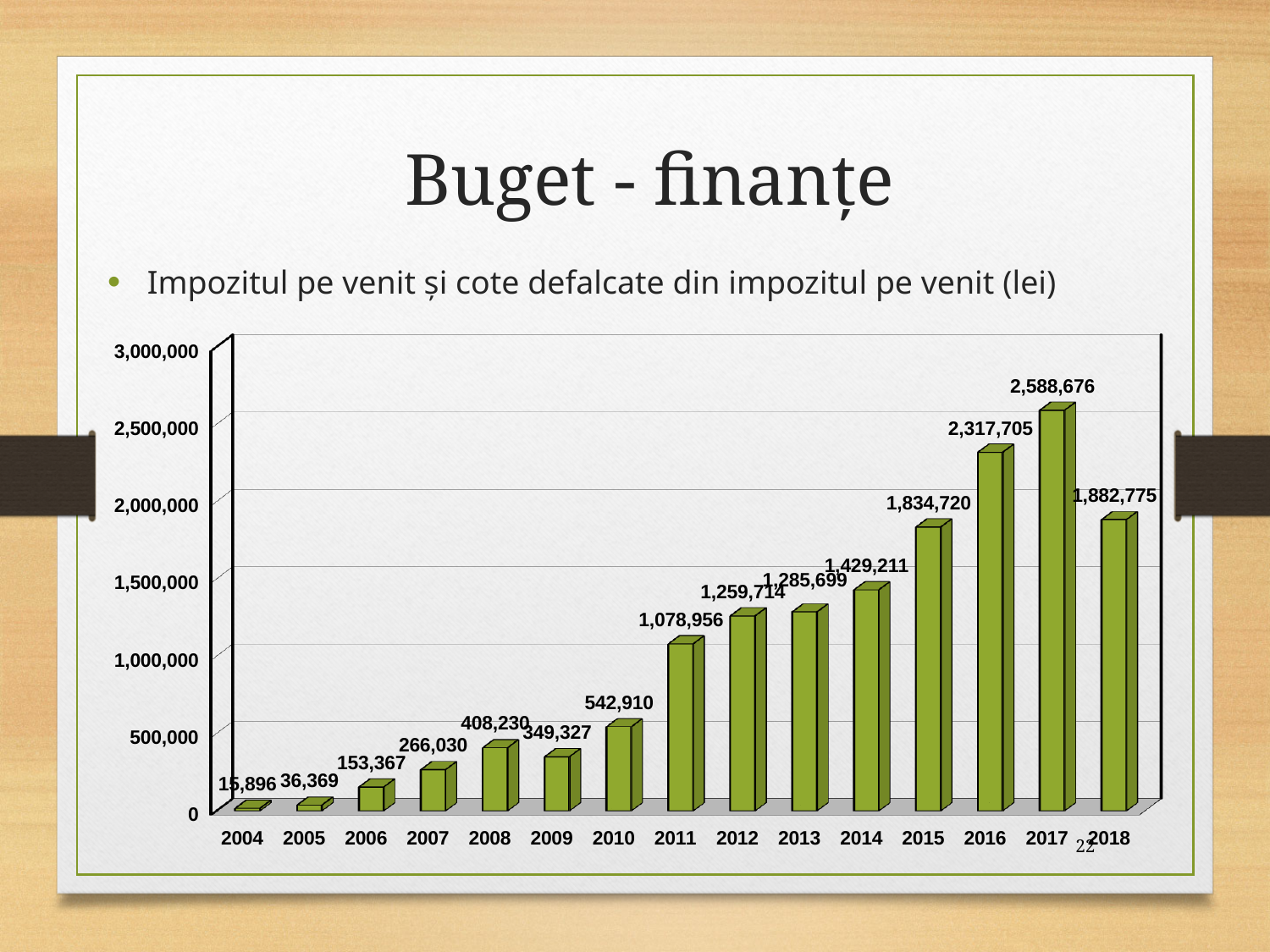
Do the values generally rise or fall from 2004 to 2017? rise How many years are shown on the x axis? 15 Is the value for 2015 greater or less than 1,500,000? greater Which year has the lowest value? 2004 What is the value for 2018? 1,882,775 By how much did the value fall from 2017 to 2018? 705,901 What is the value for 2010? 542,910 Which year has the highest value? 2017 What is the difference between the values for 2017 and 2016? 270,971 What kind of chart is shown on the slide? bar chart Which year has the larger value, 2008 or 2009? 2008 What is the value for 2017? 2,588,676